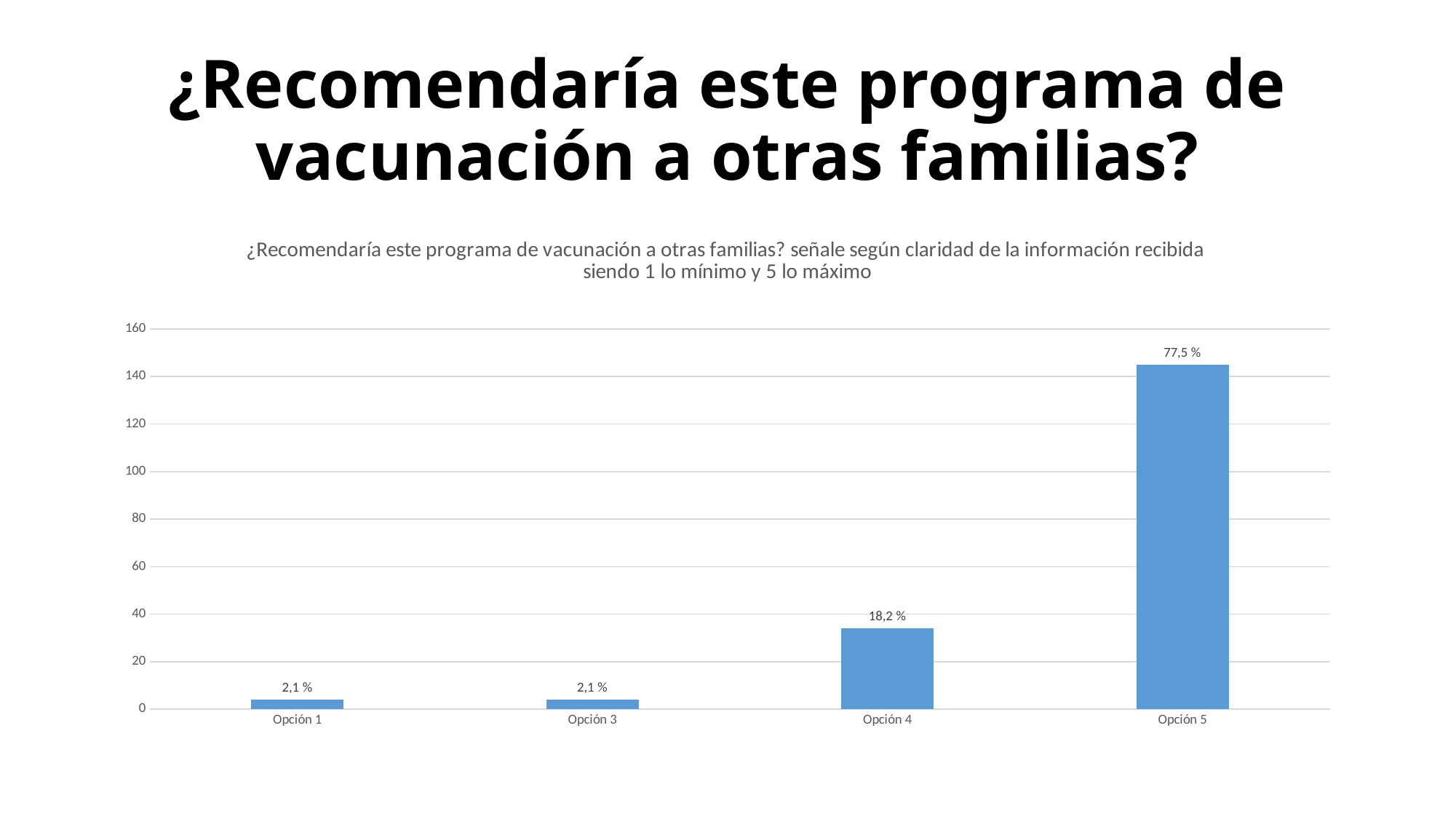
What is the difference between the data labels of Opción 5 and Opción 4? 59,3 % Which category has the highest bar? Opción 5 Which has a larger value, Opción 4 or Opción 1? Opción 4 What is the data label shown for Opción 5? 77,5 % What is the data label shown for Opción 4? 18,2 % What is the data label shown for Opción 3? 2,1 % Is the value for Opción 5 greater or less than 120 on the vertical axis? greater Is the value for Opción 4 greater or less than 40 on the vertical axis? less What kind of chart is shown on the slide? bar chart What is the data label shown for Opción 1? 2,1 % What is the highest value shown on the vertical axis? 160 How many categories are shown on the x axis? 4